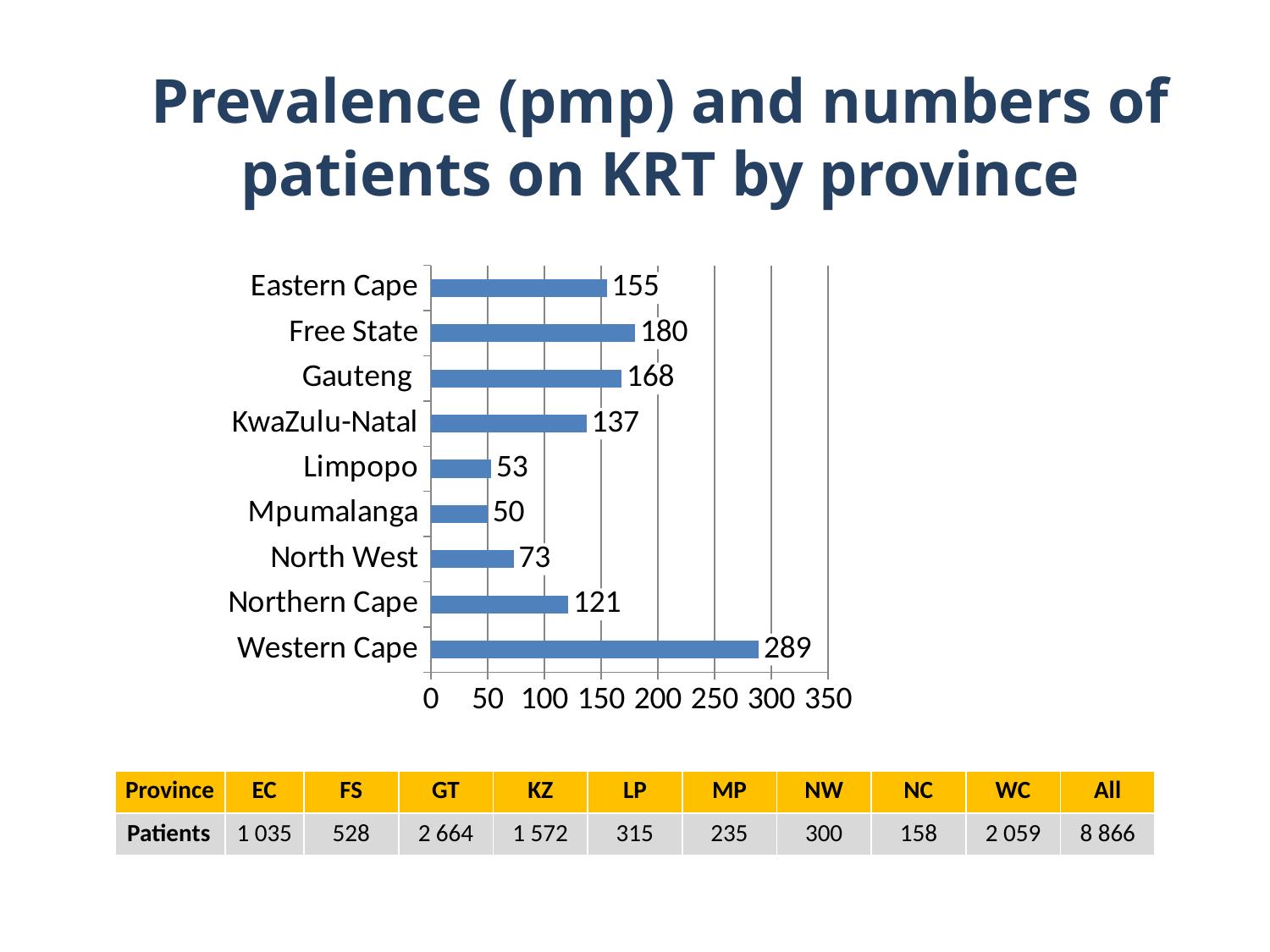
What is the prevalence (pmp) value shown for KwaZulu-Natal? 137 Which province has the lowest prevalence (pmp) in the bar chart? Mpumalanga What is the maximum value shown on the horizontal axis of the bar chart? 350 Which province has the highest prevalence (pmp) in the bar chart? Western Cape What is the prevalence (pmp) value shown for Northern Cape? 121 What is the difference between the prevalence values for Free State and Gauteng? 12 How many provinces are shown in the bar chart? 9 Is the prevalence value for Gauteng greater or less than 150? greater What is the difference between the prevalence values for Western Cape and Eastern Cape? 134 What is the prevalence (pmp) value shown for Western Cape? 289 Which has a higher prevalence (pmp), Limpopo or North West? North West What kind of chart is used to show prevalence by province? Bar chart